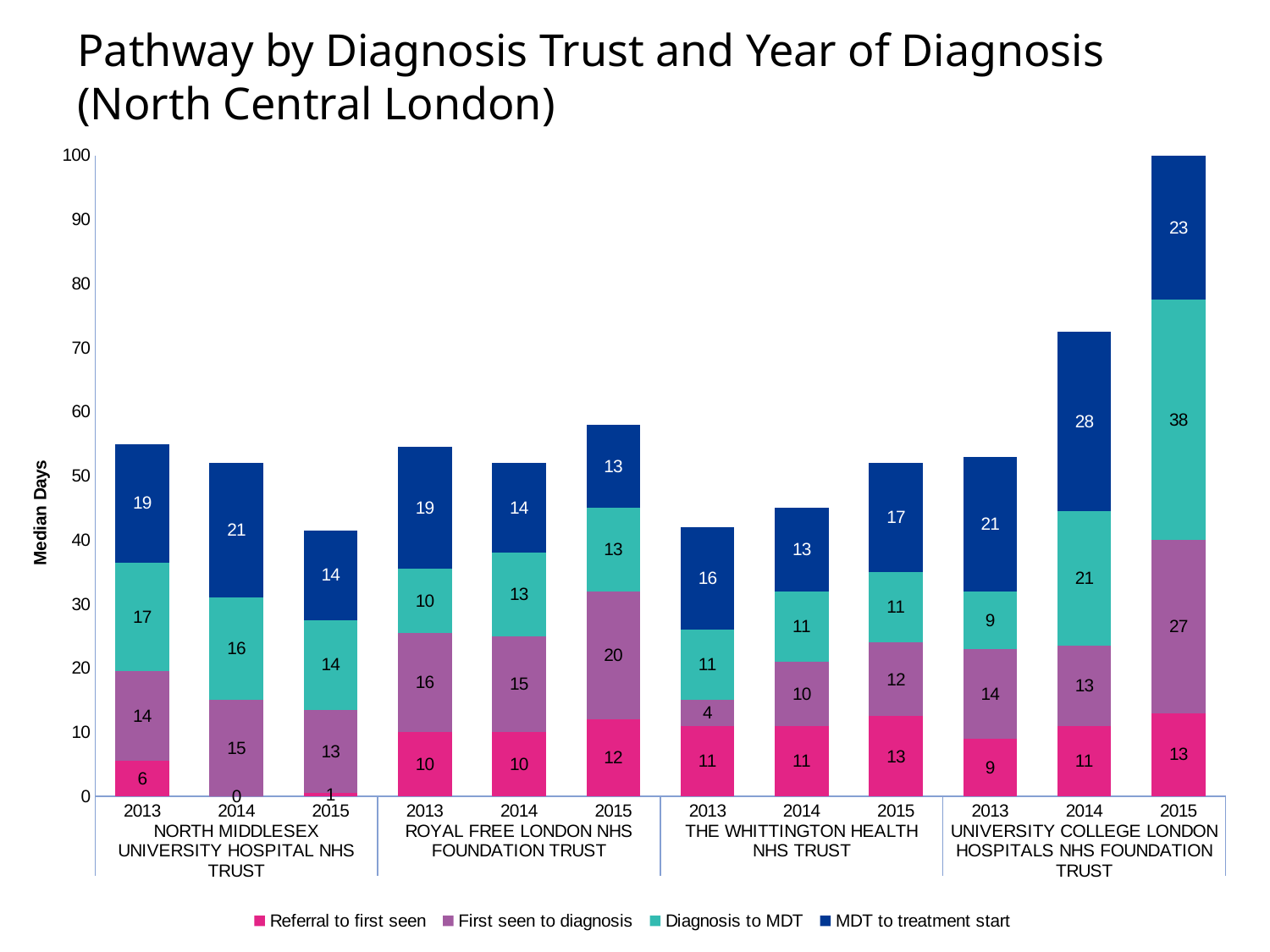
What is the difference between the 'First seen to diagnosis' values for Royal Free London NHS Foundation Trust in 2015 and 2014? 5 What kind of chart is shown on the slide? Stacked bar chart Is the 'MDT to treatment start' value larger for University College London Hospitals NHS Foundation Trust in 2014 or in 2015? 2014 What is the total of the stacked bar for Royal Free London NHS Foundation Trust in 2015? 58 Which trust and year has the tallest stacked bar? University College London Hospitals NHS Foundation Trust, 2015 What is the 'MDT to treatment start' value for University College London Hospitals NHS Foundation Trust in 2014? 28 What is the 'Diagnosis to MDT' value for University College London Hospitals NHS Foundation Trust in 2015? 38 Is the total stacked bar for University College London Hospitals NHS Foundation Trust in 2014 greater or less than 70? greater What is the 'First seen to diagnosis' value for The Whittington Health NHS Trust in 2013? 4 What is the total of the stacked bar for The Whittington Health NHS Trust in 2014? 45 How many series does the legend list? 4 What is the 'Referral to first seen' value for North Middlesex University Hospital NHS Trust in 2014? 0